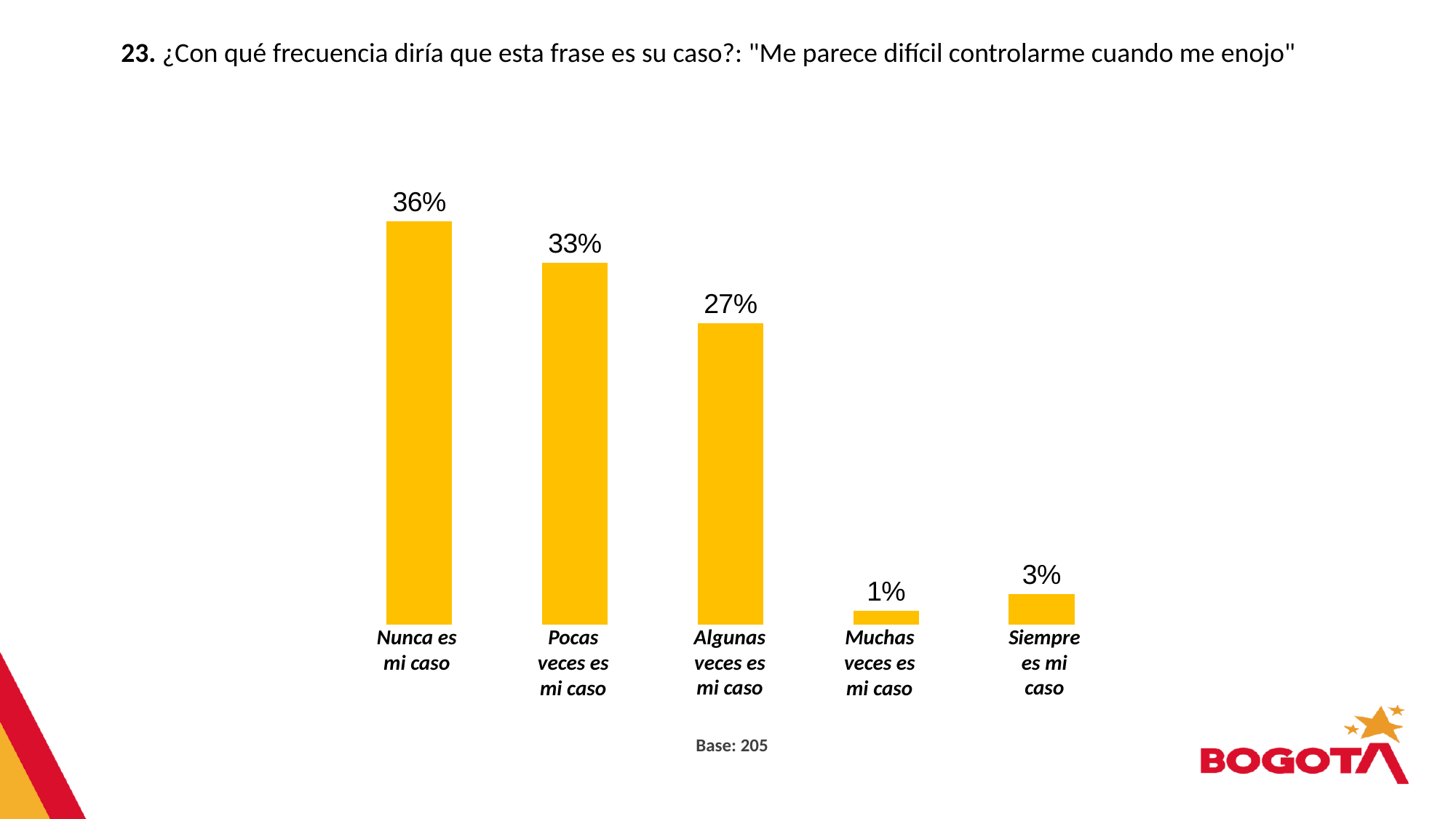
What is the base (number of respondents) stated below the chart? 205 Which is larger, the value for "Siempre es mi caso" or the value for "Muchas veces es mi caso"? Siempre es mi caso Which category has the lowest value? Muchas veces es mi caso What percentage of respondents answered "Nunca es mi caso"? 36% What is the difference between the values for "Pocas veces es mi caso" and "Algunas veces es mi caso"? 6% What kind of chart is shown on the slide? Bar chart What is the difference between the values for "Nunca es mi caso" and "Pocas veces es mi caso"? 3% What colour are the bars in the chart? Yellow Which category has the highest value? Nunca es mi caso What is the value shown for "Algunas veces es mi caso"? 27% How many categories are shown in the chart? 5 What is the value shown for "Siempre es mi caso"? 3%